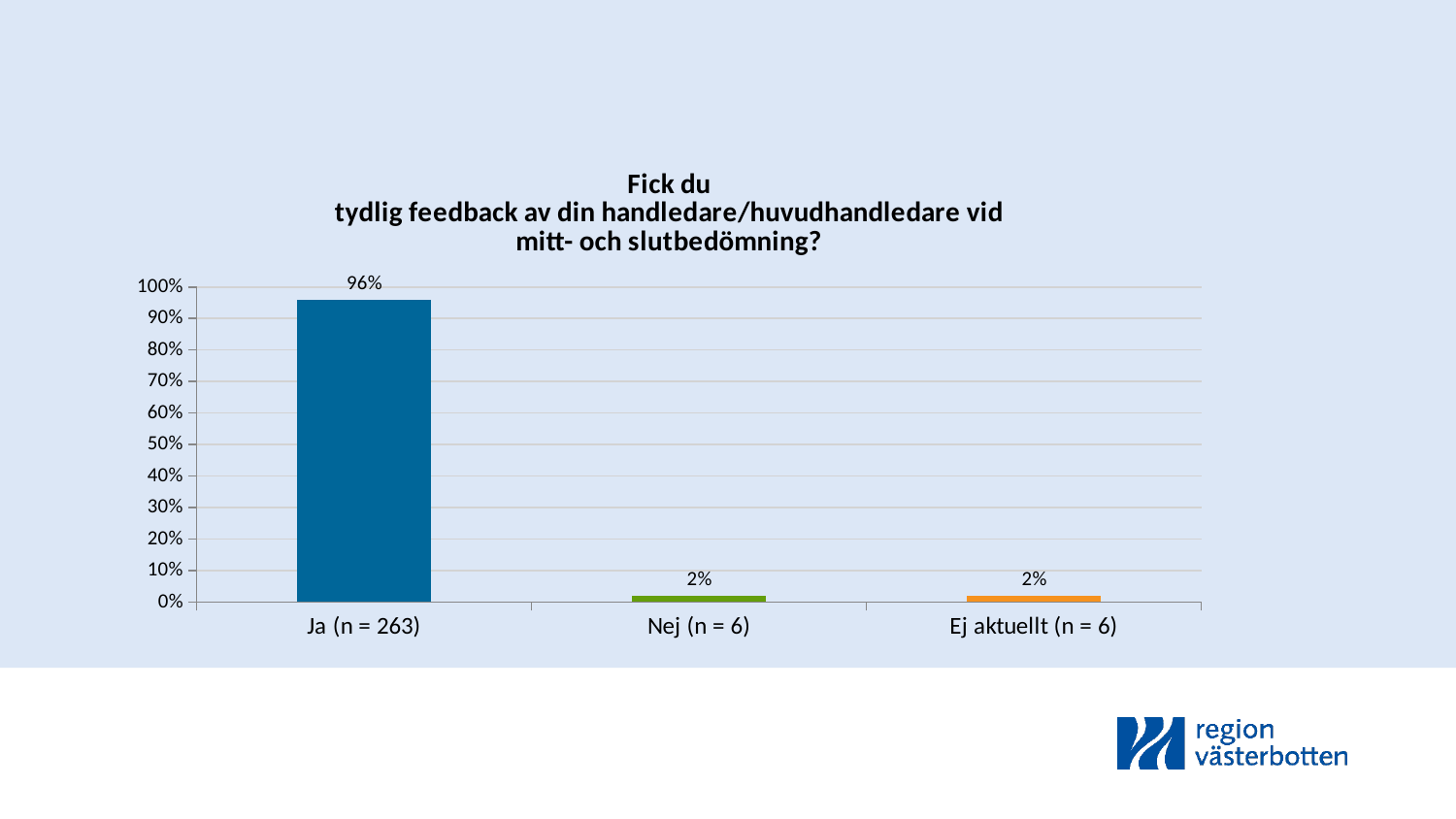
How many categories are shown on the x axis? 3 Which is larger, the value for "Ja (n = 263)" or the value for "Ej aktuellt (n = 6)"? Ja (n = 263) What is the value for "Nej (n = 6)"? 2% Is the value for "Nej (n = 6)" greater or less than 10%? less What kind of chart is shown on the slide? bar chart What is the value for "Ja (n = 263)"? 96% What is the highest value shown on the y axis? 100% Which category has the highest value? Ja (n = 263) Is the value for "Ja (n = 263)" greater or less than 50%? greater What is the value for "Ej aktuellt (n = 6)"? 2% What is the difference between the values for "Ja (n = 263)" and "Nej (n = 6)"? 94% What colour is the bar for "Ja (n = 263)"? blue